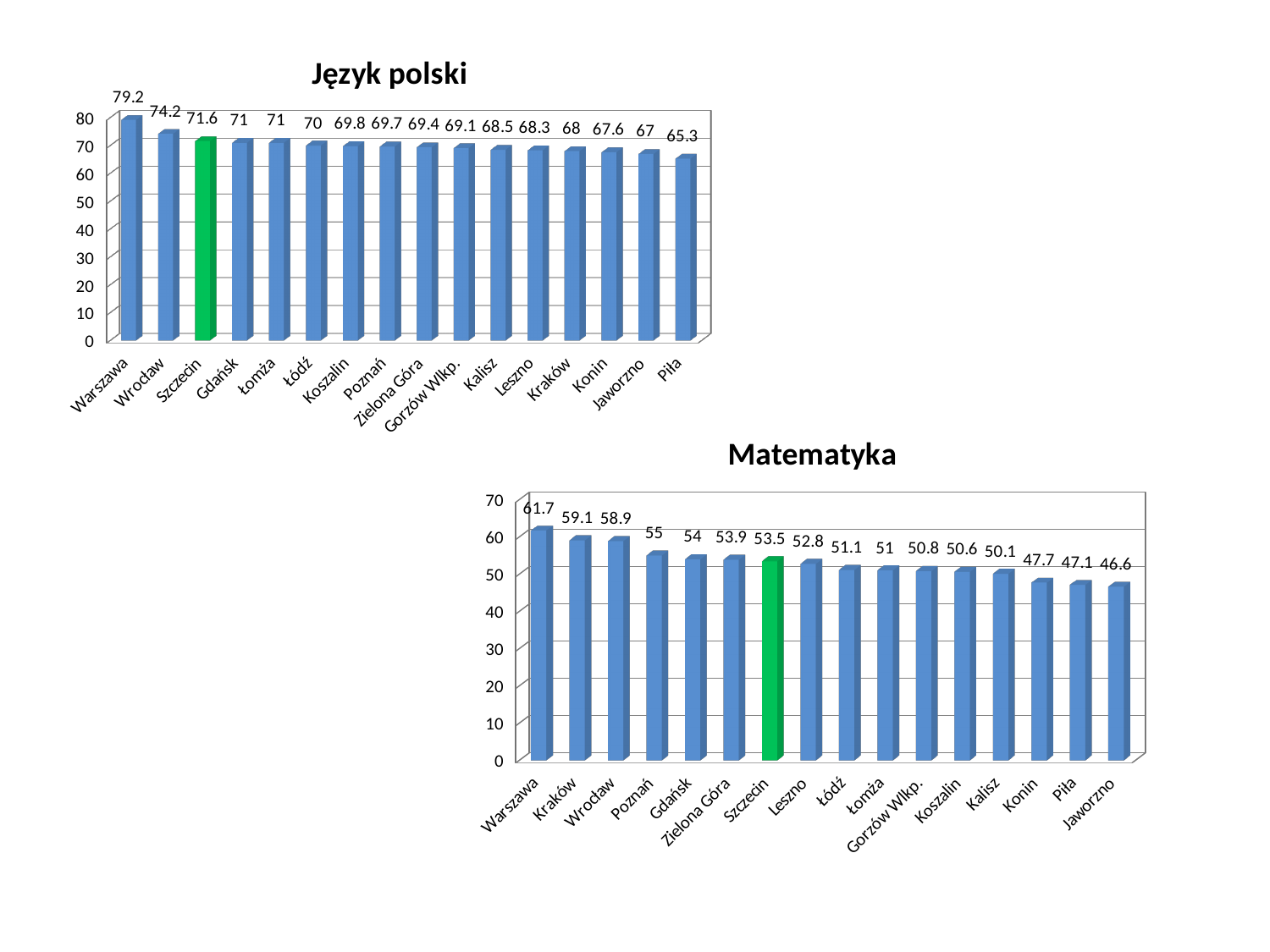
In the 'Język polski' chart, what is the difference between the values for Warszawa and Piła? 13.9 In the 'Język polski' chart, what is the value for Szczecin? 71.6 In the 'Matematyka' chart, what is the value for Kraków? 59.1 In the 'Matematyka' chart, do the values rise or fall from left to right? fall In the 'Matematyka' chart, which city has the lowest value? Jaworzno How many cities are shown in the 'Język polski' chart? 16 In the 'Matematyka' chart, which city's bar is coloured green? Szczecin What kind of chart is the 'Matematyka' chart? bar chart In the 'Język polski' chart, what is the value for Gorzów Wlkp.? 69.1 In the 'Matematyka' chart, is the value for Konin greater or less than 50? less In the 'Matematyka' chart, which is larger, the value for Poznań or the value for Gdańsk? Poznań In the 'Język polski' chart, which city has the highest value? Warszawa